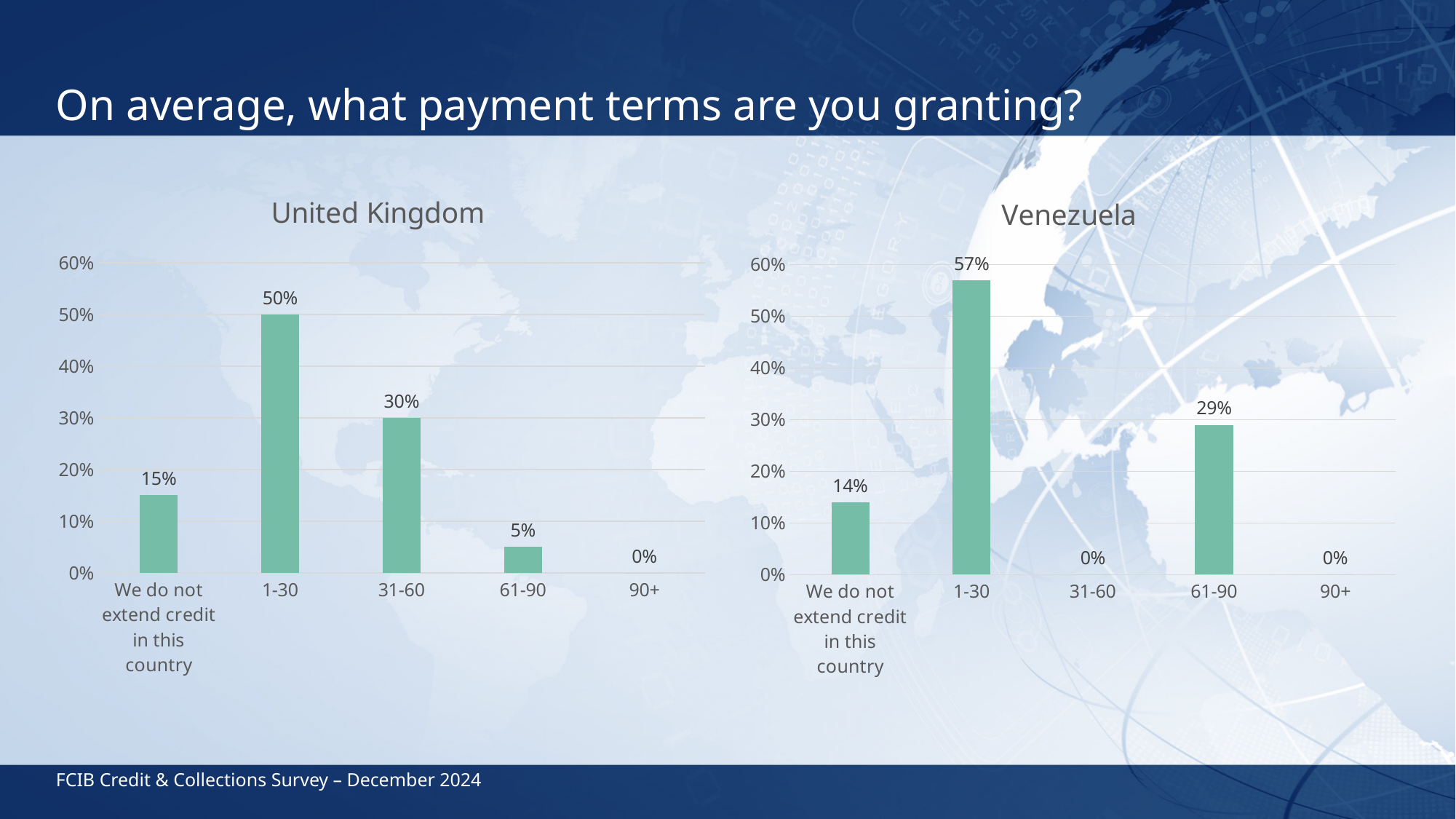
In the Venezuela chart, what is the value for 61-90? 29% In the United Kingdom chart, what is the difference between the values for 1-30 and 31-60? 20% In the United Kingdom chart, what is the value for 'We do not extend credit in this country'? 15% How many categories are shown on the x axis of the United Kingdom chart? 5 In the Venezuela chart, which category has the highest value? 1-30 In the Venezuela chart, what is the difference between the values for 1-30 and 61-90? 28% What kind of chart is the Venezuela chart? Bar chart In the United Kingdom chart, which category has the highest value? 1-30 In the Venezuela chart, is the value for 1-30 greater or less than 50%? greater Which is larger: the value for 61-90 in the United Kingdom chart or the value for 61-90 in the Venezuela chart? Venezuela In the Venezuela chart, what is the value for 31-60? 0% In the United Kingdom chart, what is the value for 1-30? 50%